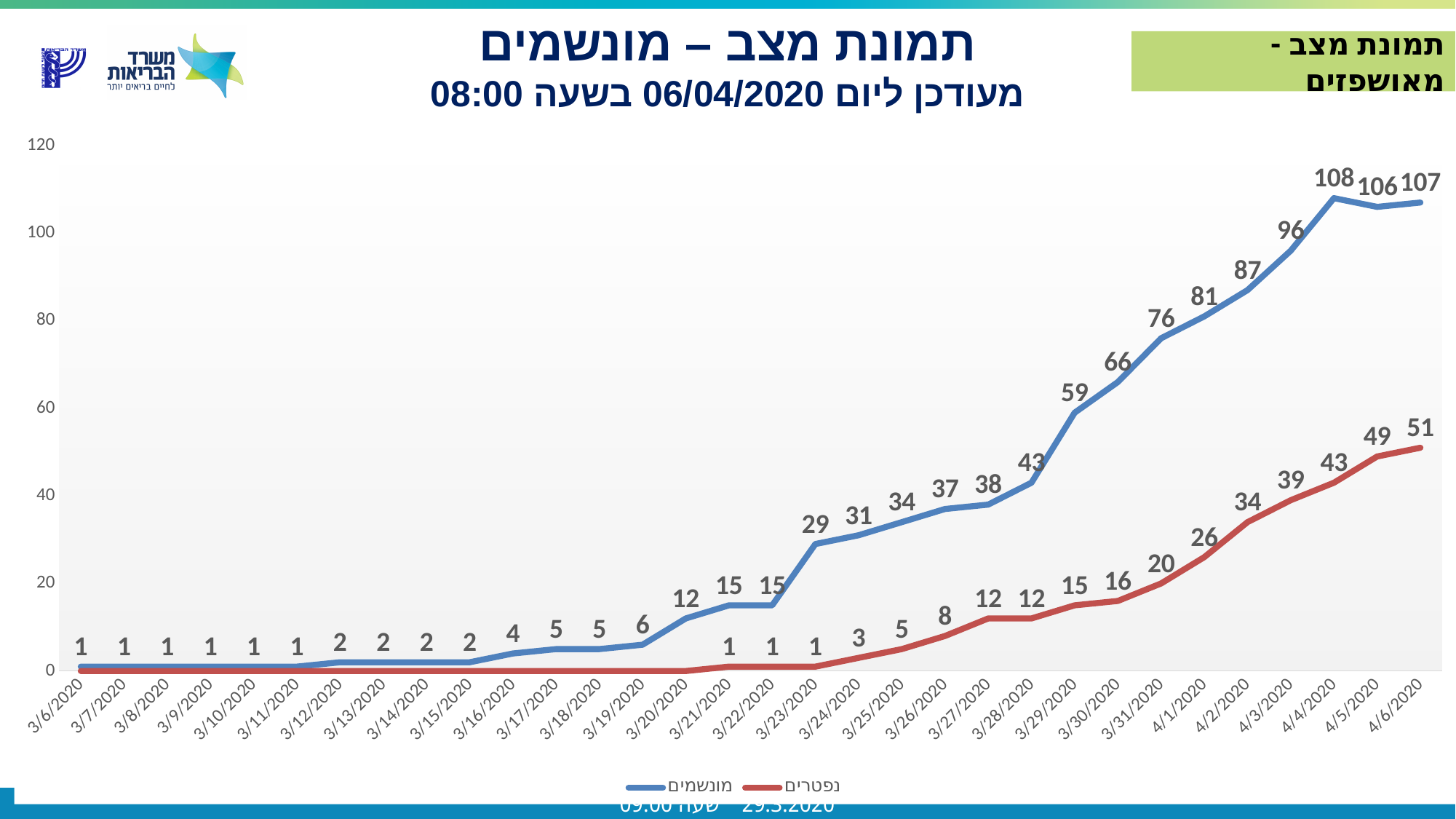
What is the value of the מונשמים series on 3/23/2020? 29 What is the value of the מונשמים series on 4/4/2020? 108 How many dates are shown on the x axis? 32 Does the נפטרים series generally rise or fall from 3/21/2020 to 4/6/2020? rise Is the value of the מונשמים series on 4/3/2020 greater or less than 100? less What colour is the line for the נפטרים series? red What is the value of the נפטרים series on 4/6/2020? 51 On which date does the מונשמים series reach its highest value? 4/4/2020 Which series has the larger value on 4/1/2020, מונשמים or נפטרים? מונשמים What type of chart is shown on the slide? line chart How many series does the legend list? 2 What is the difference between the מונשמים and נפטרים values on 4/6/2020? 56